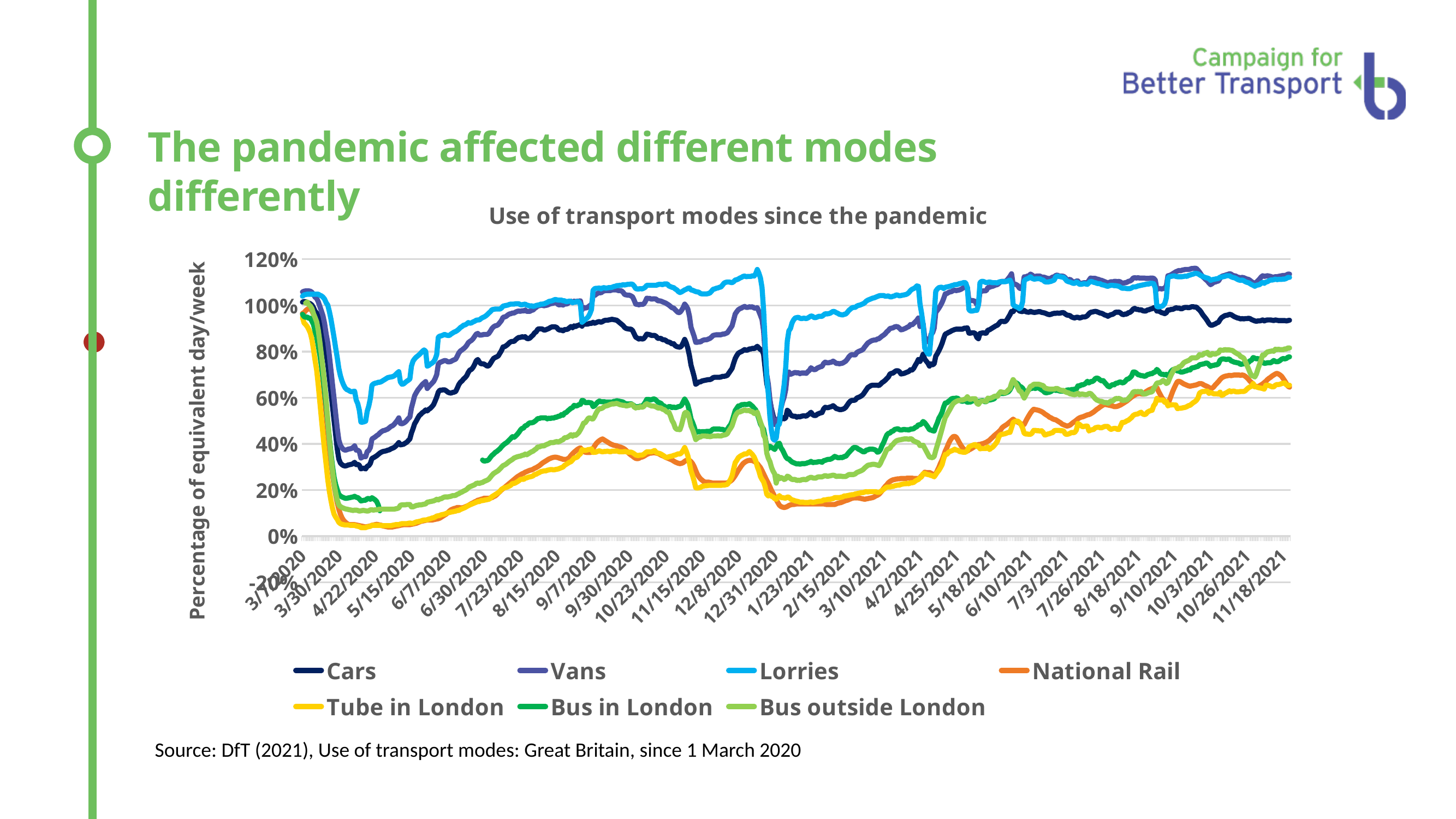
What is the label on the vertical axis of the chart? Percentage of equivalent day/week What is the title of the chart? Use of transport modes since the pandemic At 11/18/2021, which is larger: Vans or National Rail? Vans At 11/18/2021, which is larger: Lorries or Tube in London? Lorries Does the Tube in London line rise or fall between 3/1/2020 and 4/22/2020? Fall Is the value for Tube in London at 11/18/2021 greater or less than 80%? less Which series has the highest value just before the sharp drop around 12/31/2020? Lorries Is the value for Lorries at 11/18/2021 greater or less than 100%? greater What kind of chart is shown on the slide? Line chart Is the value for Cars at 11/18/2021 greater or less than 80%? greater How many series does the legend list? 7